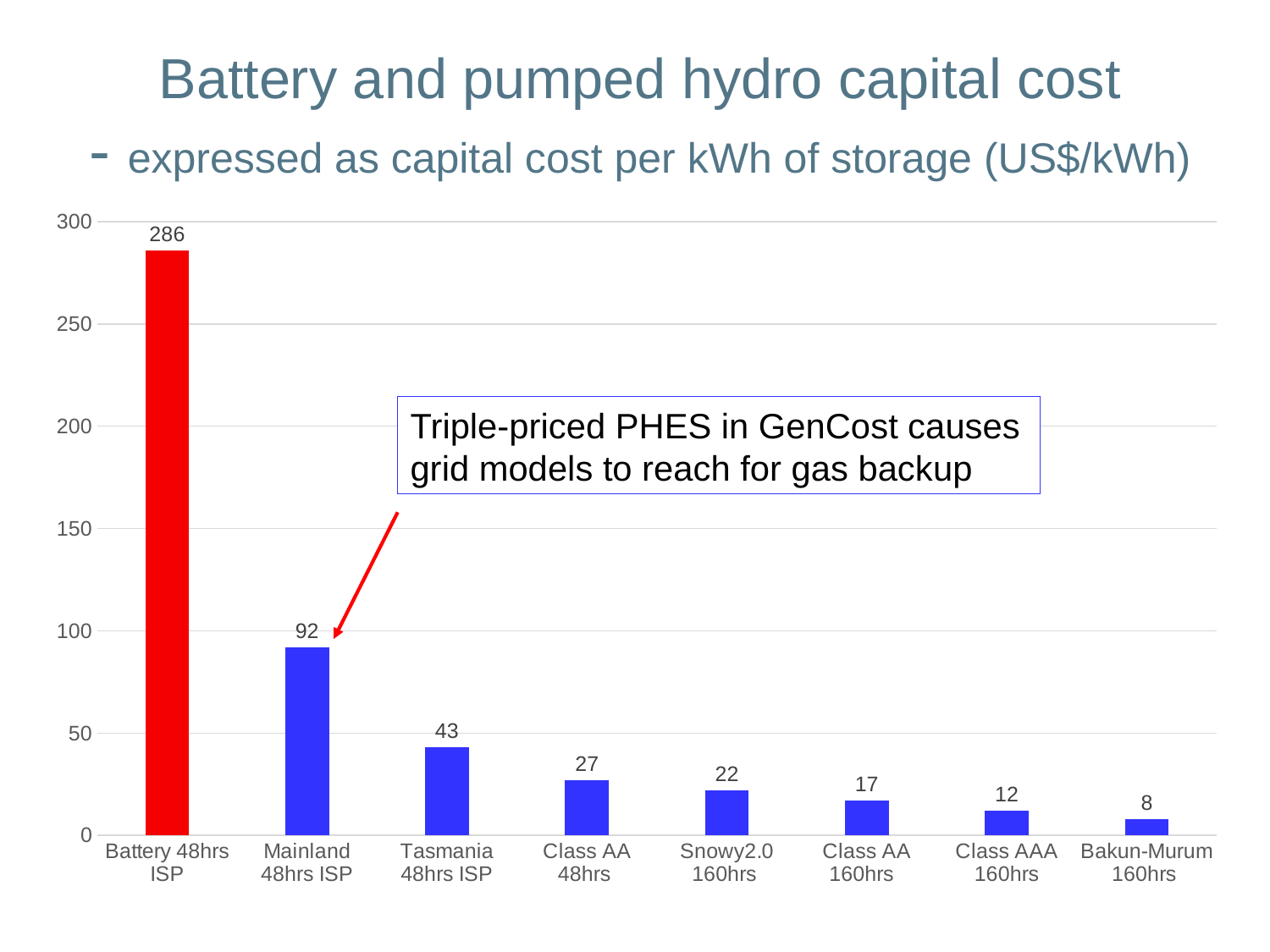
What is the difference between the values for Battery 48hrs ISP and Mainland 48hrs ISP? 194 Which category has the highest value? Battery 48hrs ISP What does the text box on the chart say? Triple-priced PHES in GenCost causes grid models to reach for gas backup What is the difference between the values for Tasmania 48hrs ISP and Class AA 48hrs? 16 Is the value for Tasmania 48hrs ISP greater or less than 50? less What is the capital cost value for Battery 48hrs ISP? 286 How many categories are shown on the x axis? 8 What is the value shown for Snowy2.0 160hrs? 22 Which category has the lowest value? Bakun-Murum 160hrs Which is larger, the value for Class AA 160hrs or the value for Class AAA 160hrs? Class AA 160hrs What kind of chart is shown on the slide? bar chart What is the value shown for Mainland 48hrs ISP? 92